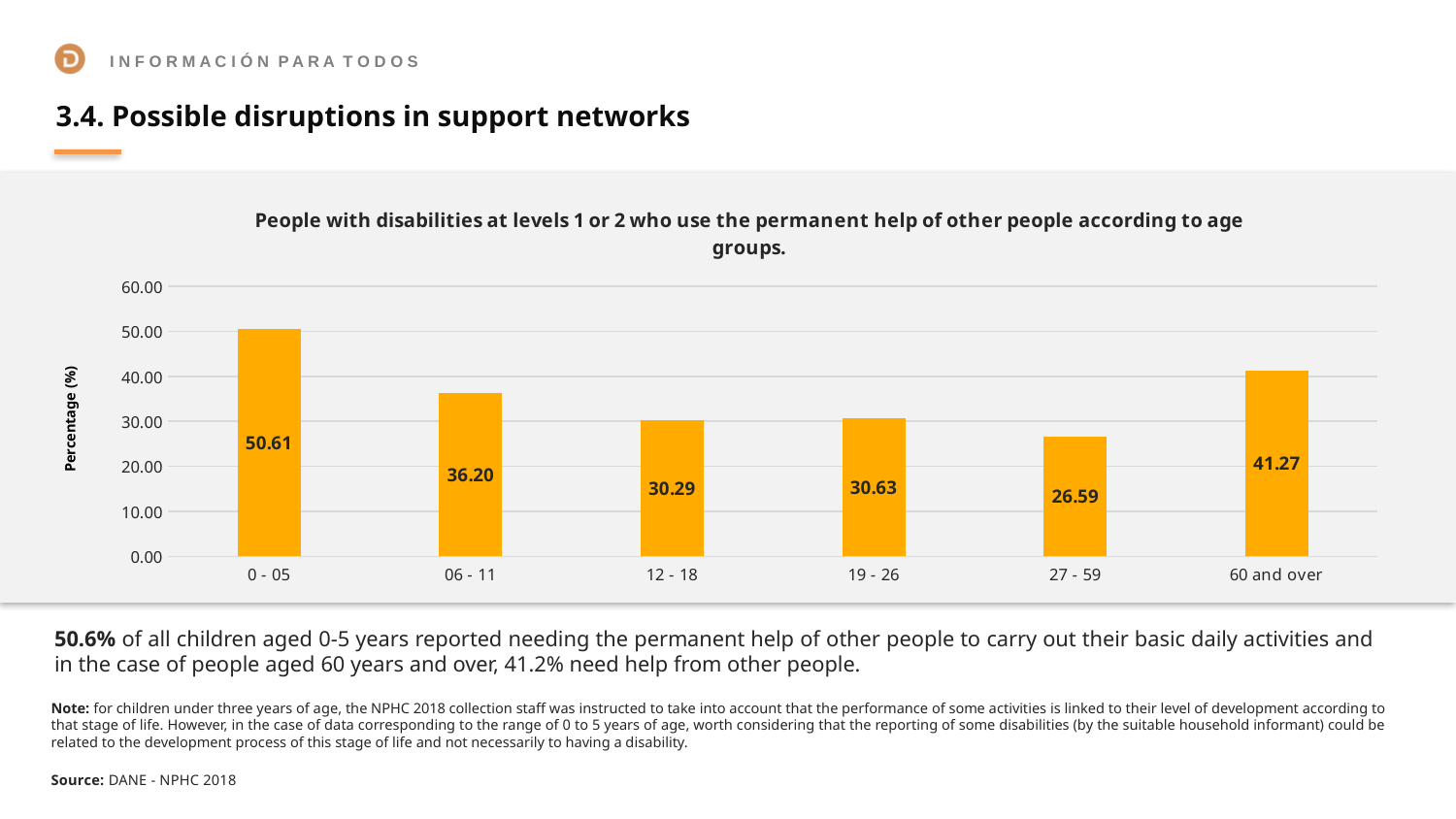
What is the difference between the values for 19 - 26 and 12 - 18? 0.34 Which is larger, the value for 06 - 11 or the value for 19 - 26? 06 - 11 Which age group has the highest value? 0 - 05 Which age group has the lowest value? 27 - 59 What is the value for the 0 - 05 age group? 50.61 What is the label of the vertical axis? Percentage (%) How many age groups are shown on the x axis? 6 Is the value for 12 - 18 greater or less than 40.00? less What is the value for the 60 and over age group? 41.27 What kind of chart is shown on the slide? bar chart What is the value for the 27 - 59 age group? 26.59 What is the difference between the values for 0 - 05 and 60 and over? 9.34